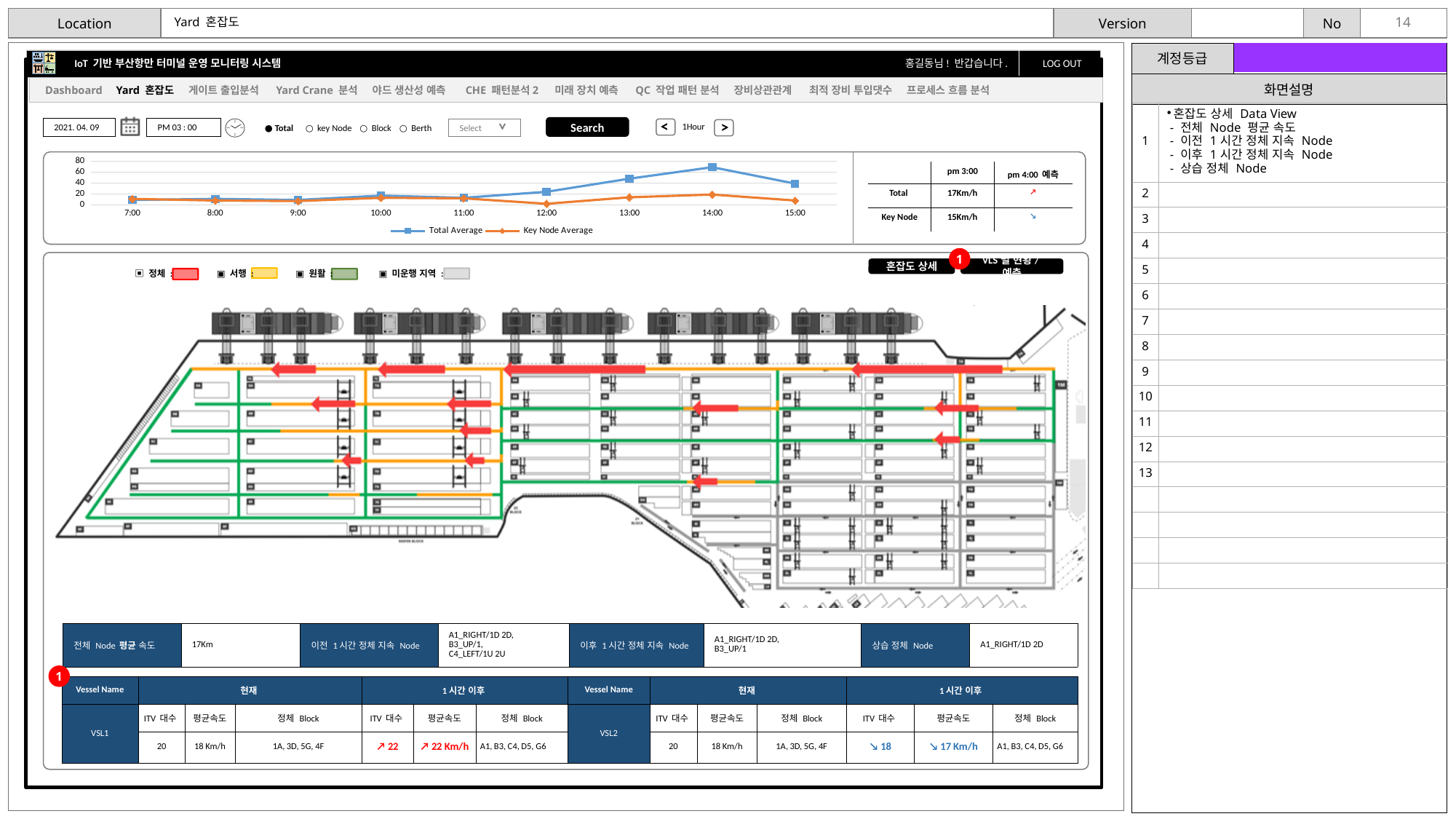
What kind of chart is shown at the top of the slide? line chart At 14:00, which series has the larger value, Total Average or Key Node Average? Total Average Is the Total Average value at 8:00 greater or less than 40? less At which time does the Key Node Average series reach its highest value? 14:00 Does the Total Average series rise or fall between 12:00 and 14:00? rise Is the Key Node Average value at 14:00 greater or less than 40? less Is the Total Average value at 14:00 greater or less than 40? greater How many time points are shown along the x axis of the line chart? 9 How many series does the legend of the line chart list? 2 What colour is the Total Average line in the chart? blue Does the Total Average series rise or fall between 14:00 and 15:00? fall At which time does the Total Average series reach its highest value? 14:00